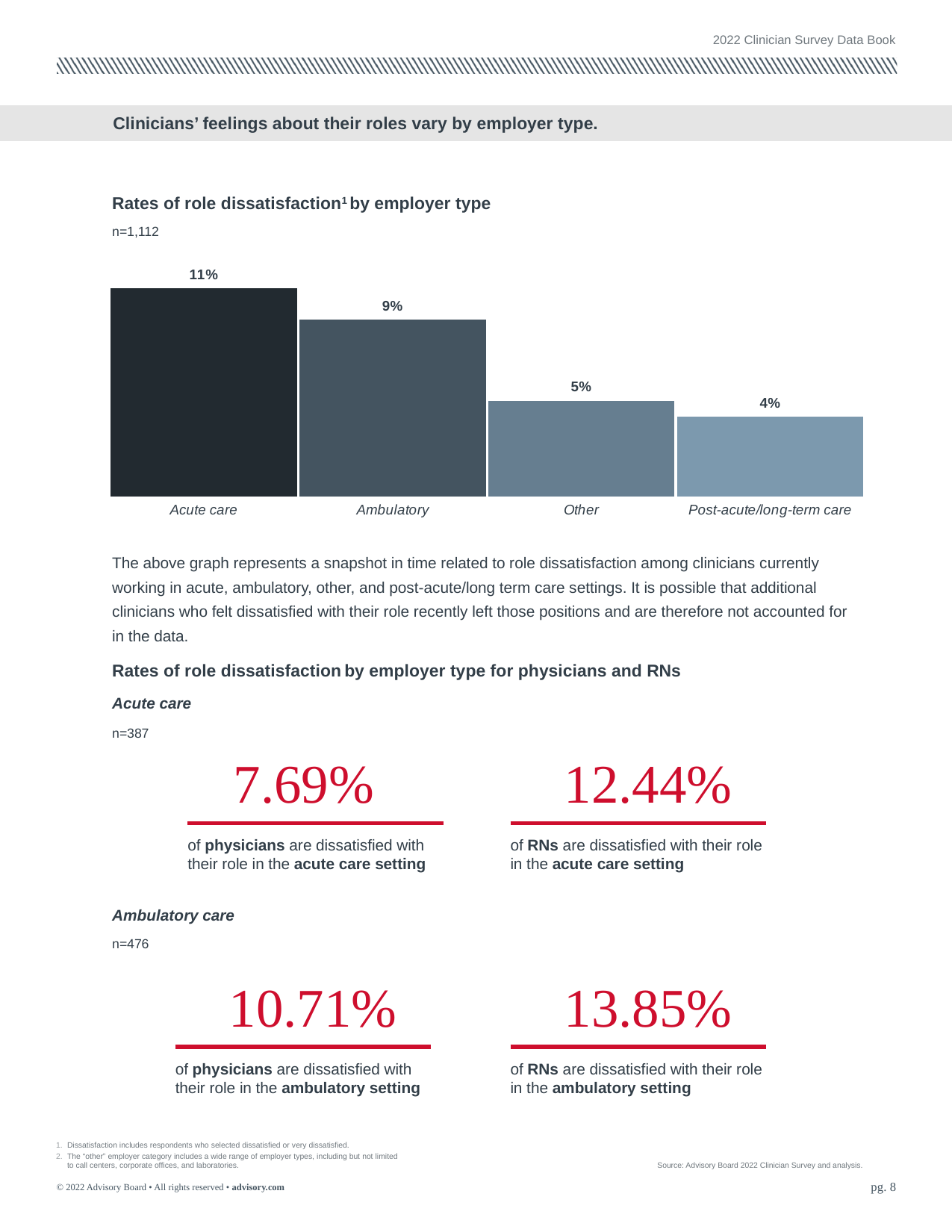
Which employer type has the highest rate of role dissatisfaction? Acute care What is the rate of role dissatisfaction for Acute care? 11% What is the rate of role dissatisfaction for Other? 5% Do the values rise or fall moving from left to right across the employer types? Fall Which employer type has the lowest rate of role dissatisfaction? Post-acute/long-term care What is the rate of role dissatisfaction for Ambulatory? 9% What is the difference in role dissatisfaction rate between Acute care and Ambulatory? 2% How many employer types are shown in the chart? 4 Which has a higher rate of role dissatisfaction, Other or Ambulatory? Ambulatory What is the difference in role dissatisfaction rate between Acute care and Post-acute/long-term care? 7% What kind of chart is used to show rates of role dissatisfaction by employer type? Bar chart What is the rate of role dissatisfaction for Post-acute/long-term care? 4%